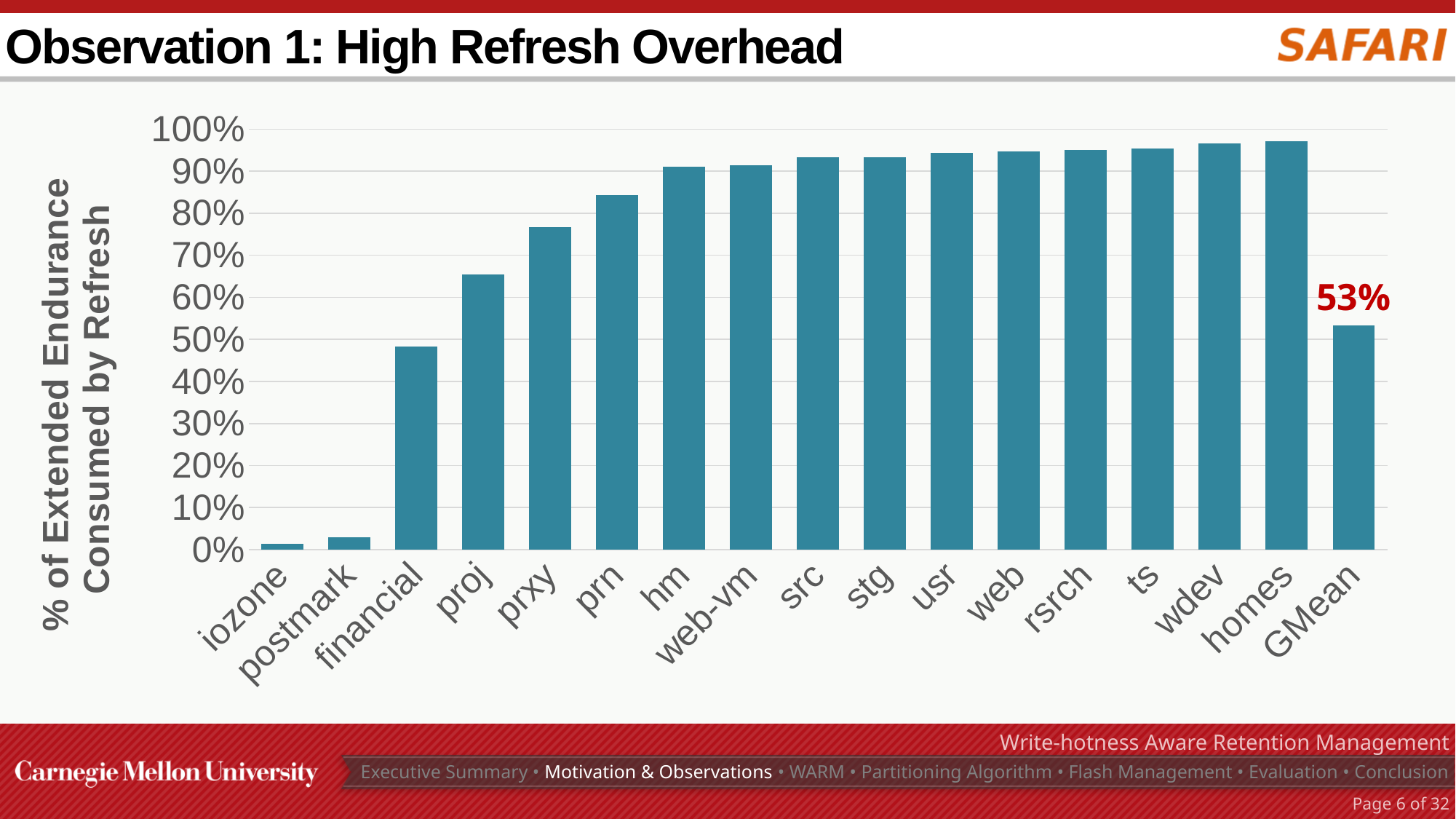
Is the value for prxy greater or less than 70%? greater Which category has the lowest bar? iozone Do the bars generally rise or fall from iozone to homes? Rise Is the value for proj greater or less than 60%? greater What is the label of the y axis? % of Extended Endurance Consumed by Refresh Which has a larger value, financial or prn? prn How many categories are shown on the x axis? 17 Which has a larger value, proj or prxy? prxy Is the value for prn greater or less than 80%? greater What kind of chart is shown on the slide? Bar chart What is the value shown for GMean? 53%